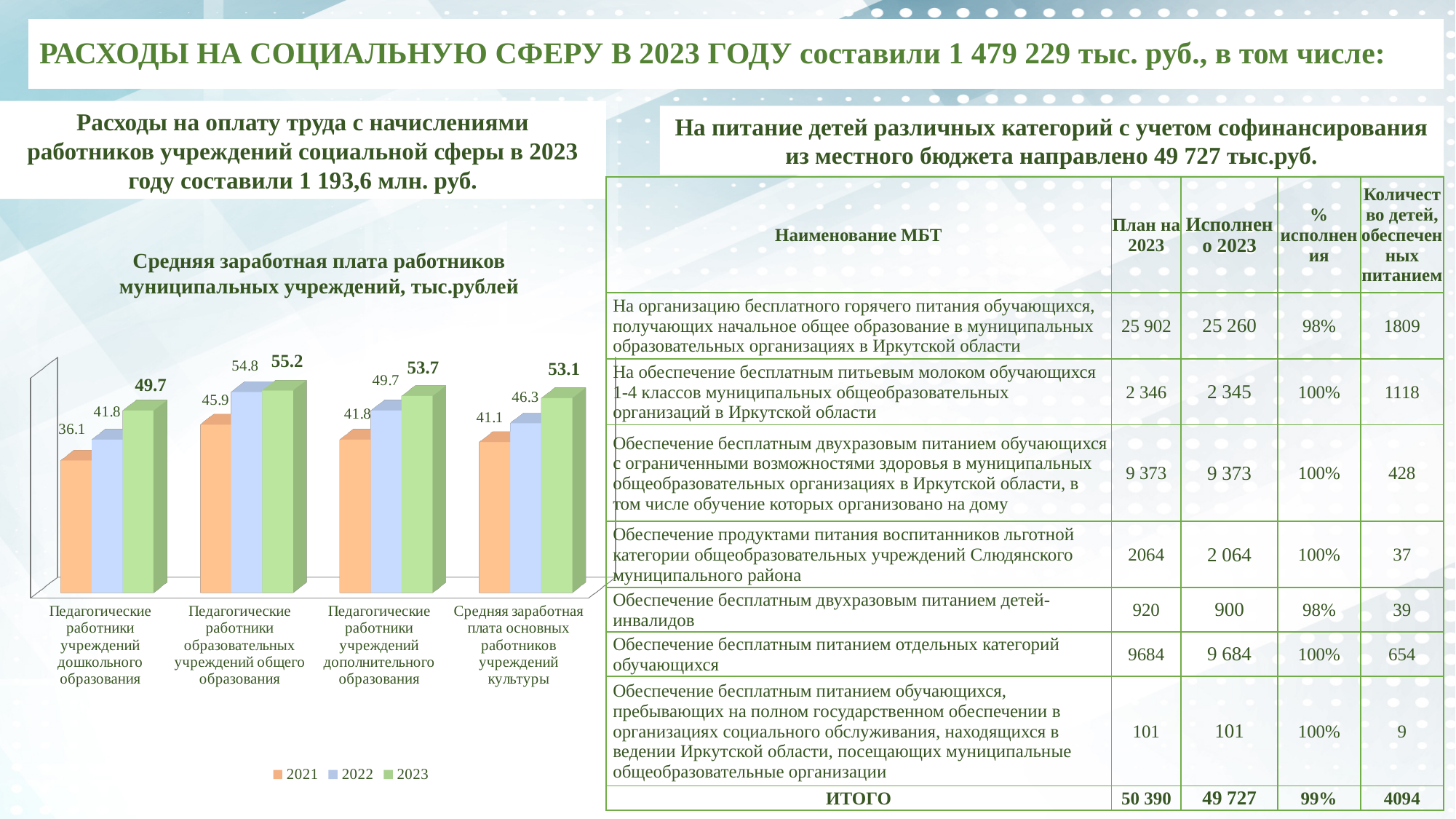
What is the title of the chart? Средняя заработная плата работников муниципальных учреждений, тыс.рублей How many series does the chart legend list? 3 Which is larger: the 2023 value for Педагогические работники учреждений дополнительного образования or the 2023 value for Средняя заработная плата основных работников учреждений культуры? Педагогические работники учреждений дополнительного образования What is the 2023 value for Педагогические работники учреждений дошкольного образования? 49.7 What type of chart is shown on the slide? bar chart How many categories are shown on the x axis of the chart? 4 Which category has the highest 2023 value? Педагогические работники образовательных учреждений общего образования Which category has the lowest 2021 value? Педагогические работники учреждений дошкольного образования What is the difference between the 2023 and 2021 values for Педагогические работники учреждений дошкольного образования? 13.6 What is the 2021 value for Педагогические работники образовательных учреждений общего образования? 45.9 Do the values for Педагогические работники учреждений дополнительного образования rise or fall from 2021 to 2023? rise What is the 2022 value for Средняя заработная плата основных работников учреждений культуры? 46.3